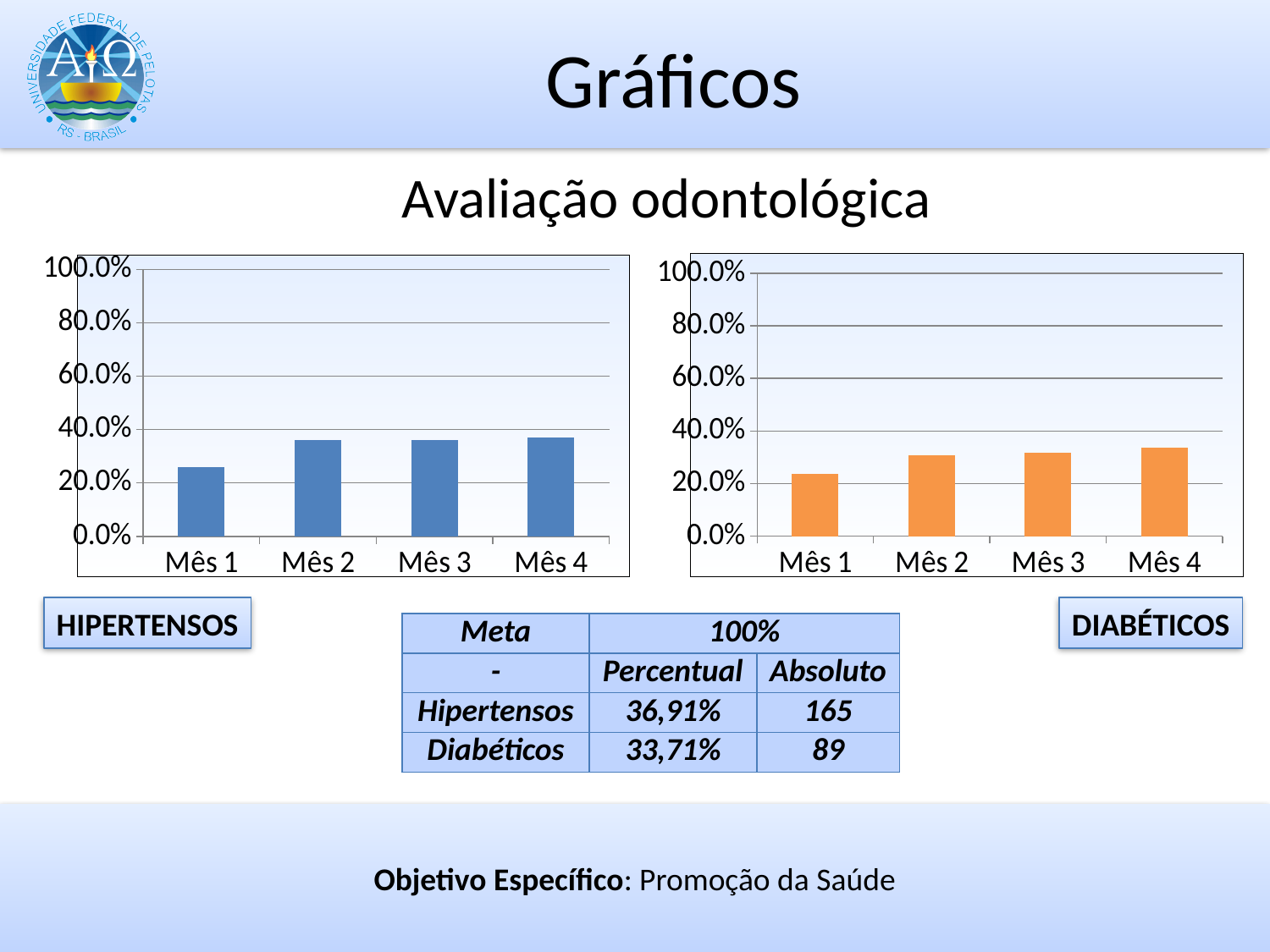
In the DIABÉTICOS chart on the right, do the values generally rise or fall from Mês 1 to Mês 4? rise In the DIABÉTICOS chart on the right, is the value for Mês 2 greater or less than 40.0%? less What colour are the bars in the DIABÉTICOS chart on the right? orange What kind of chart is the HIPERTENSOS chart on the left? bar chart How many months are shown on the x axis of the DIABÉTICOS chart on the right? 4 In the HIPERTENSOS chart on the left, which is larger, the value for Mês 1 or the value for Mês 4? Mês 4 In the DIABÉTICOS chart on the right, is the value for Mês 4 greater or less than 20.0%? greater In the HIPERTENSOS chart on the left, is the value for Mês 1 greater or less than 20.0%? greater In the DIABÉTICOS chart on the right, which month has the lowest value? Mês 1 What is the highest value shown on the y axis of the HIPERTENSOS chart on the left? 100.0% In the HIPERTENSOS chart on the left, which month has the lowest value? Mês 1